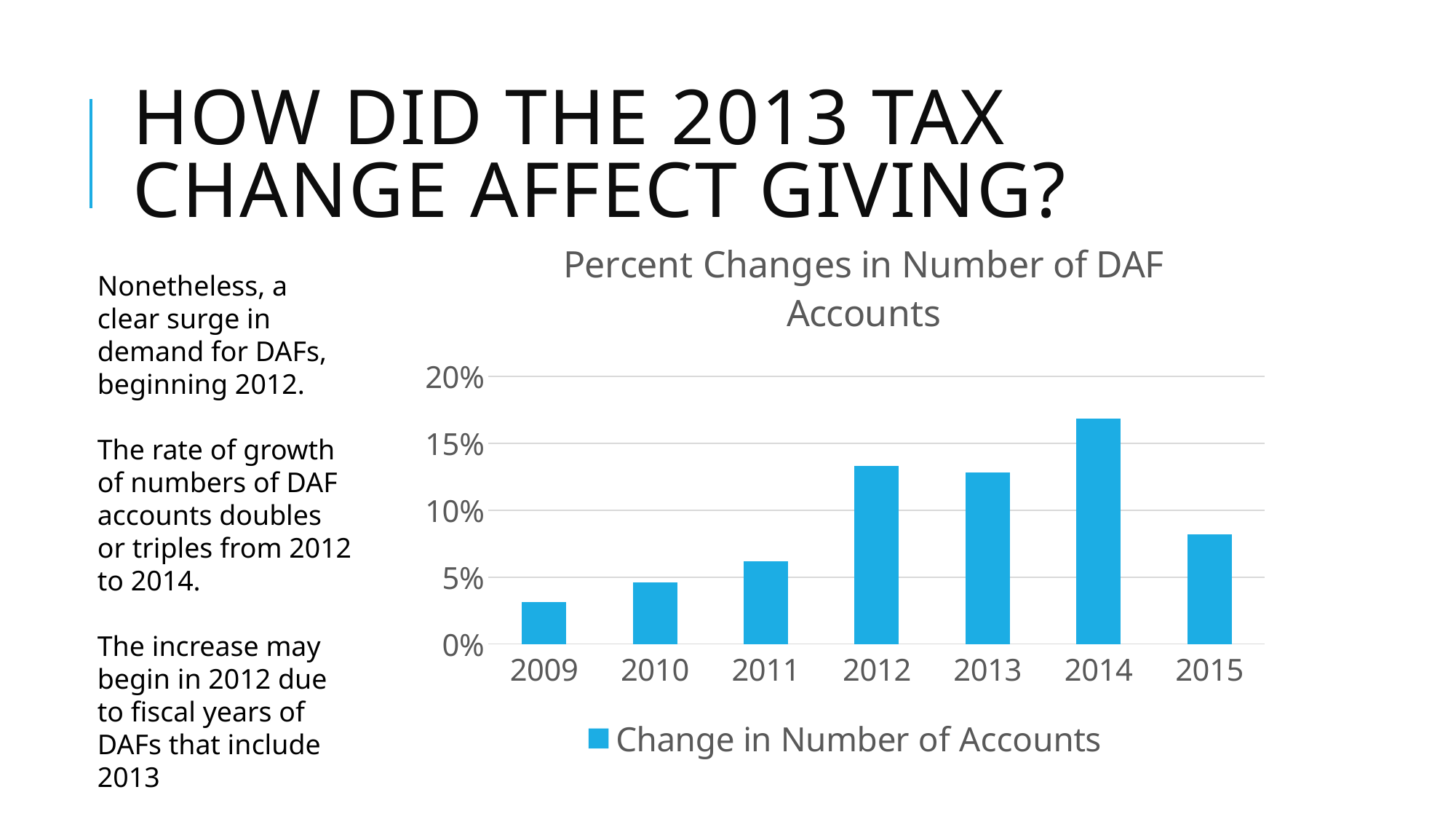
Do the values rise or fall from 2009 to 2012? rise Is the value for 2009 greater or less than 5%? less How many years are shown on the x axis of the chart? 7 What kind of chart is shown on the slide? bar chart What is the title of the chart? Percent Changes in Number of DAF Accounts Is the value for 2014 greater or less than 15%? greater Which year has the highest percent change in number of DAF accounts? 2014 Which year has the larger value, 2012 or 2011? 2012 Is the value for 2015 greater or less than 10%? less How many series does the chart's legend list? 1 What is the legend entry for the series in the chart? Change in Number of Accounts Which year has the lowest percent change in number of DAF accounts? 2009